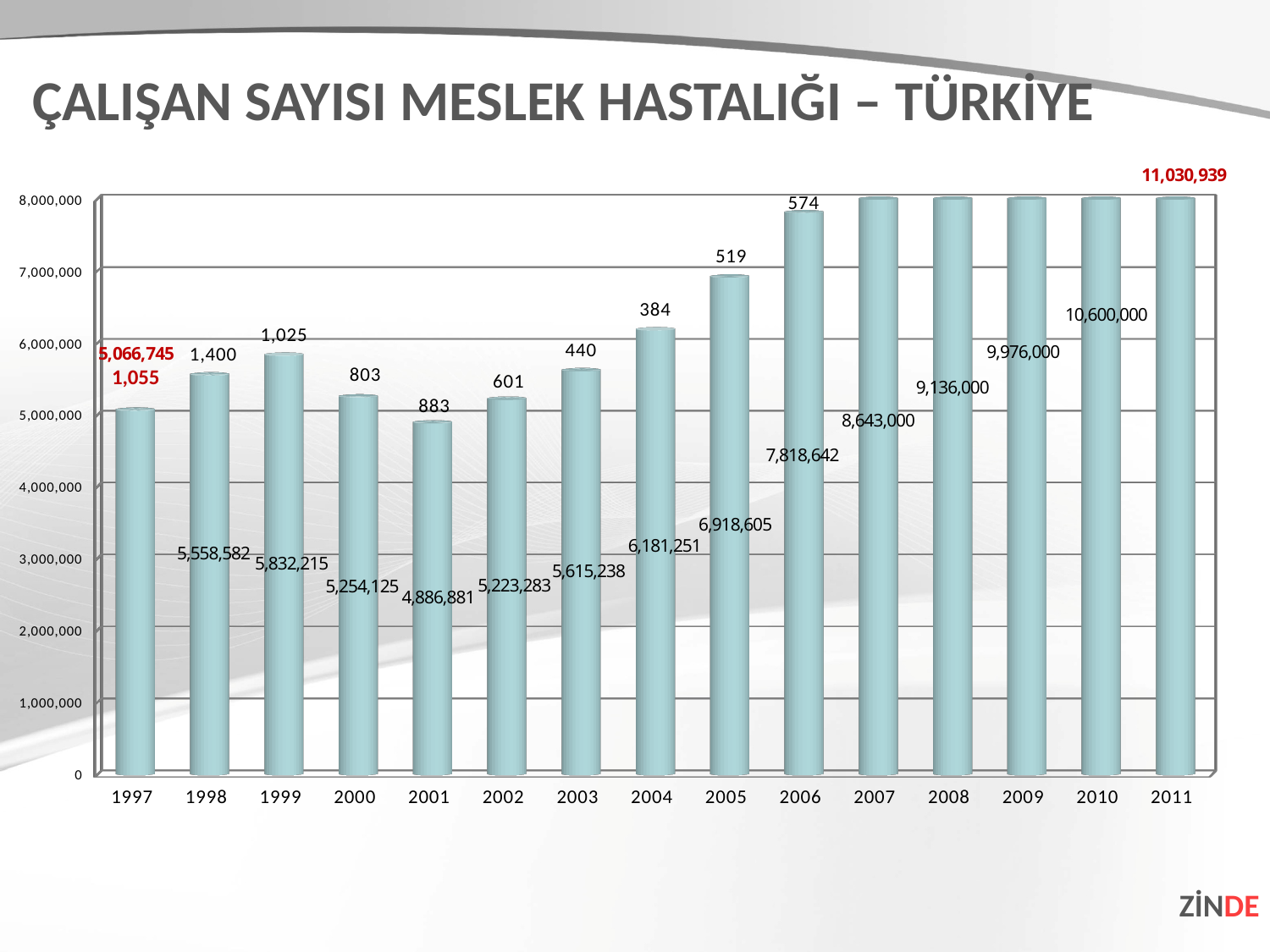
What is the worker count (çalışan sayısı) label shown for 2011? 11,030,939 What kind of chart is shown on the slide? bar chart How many years are shown on the x axis of the chart? 15 Which year has the highest occupational disease count shown? 1998 Which year has the lowest worker count label? 2001 What is the occupational disease count shown above the 2004 bar? 384 What is the worker count label shown for 2001? 4,886,881 Is the bar for 2005 greater or less than 6,000,000? greater What is the difference between the worker count labels for 1998 and 1997? 491,837 What is the occupational disease (meslek hastalığı) count shown above the 1998 bar? 1,400 Which year has the highest worker count label? 2011 Which is larger, the worker count for 2003 or for 2002? 2003